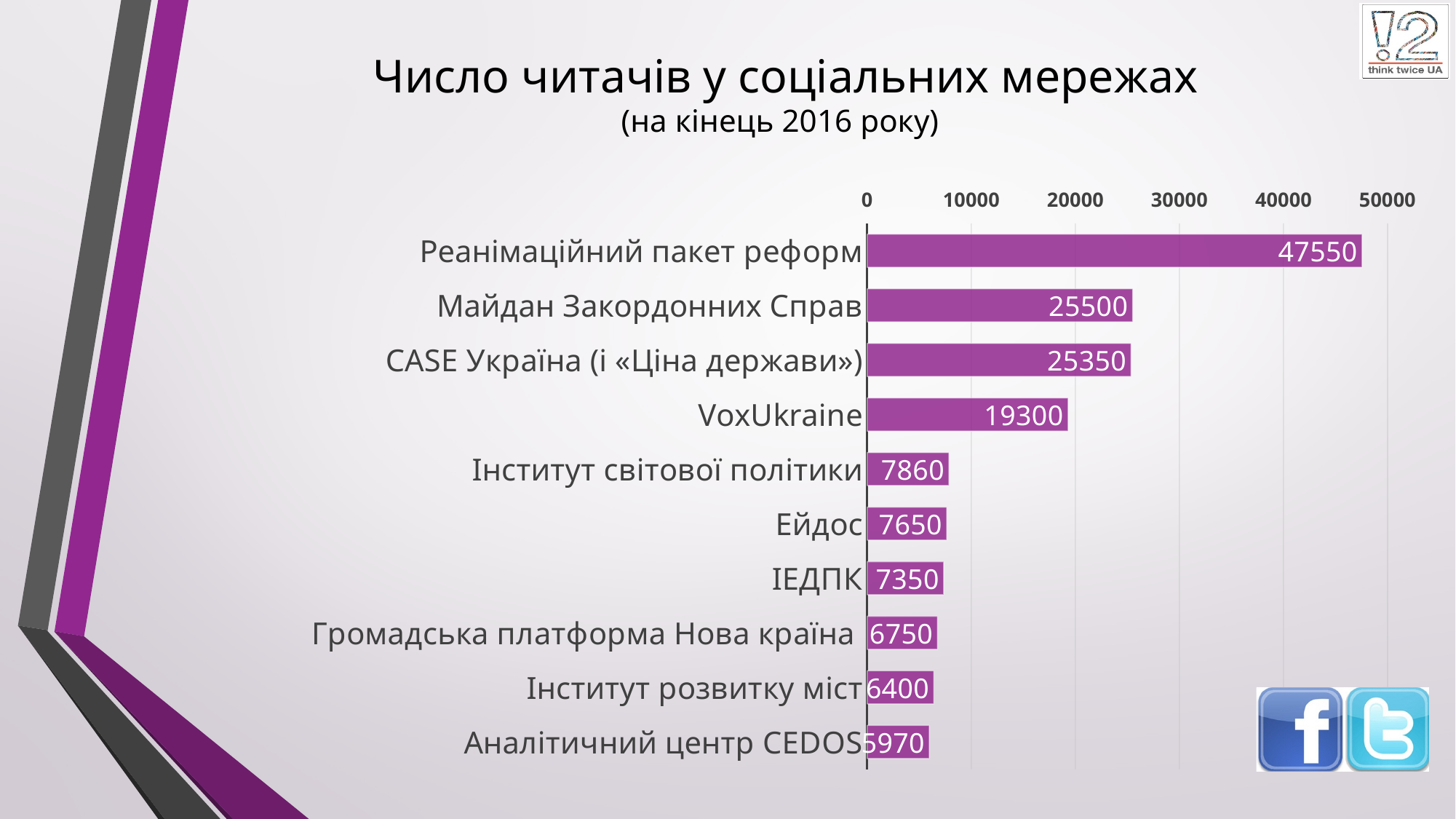
Which is larger, the value for ІЕДПК or the value for Громадська платформа Нова країна? ІЕДПК What is the value for VoxUkraine? 19300 Which category has the lowest value? Аналітичний центр CEDOS Is the value for CASE Україна (і «Ціна держави») greater or less than 20000? greater What is the value for Ейдос? 7650 How many categories are shown in the chart? 10 What is the value for Аналітичний центр CEDOS? 5970 What is the difference between the values for VoxUkraine and Інститут світової політики? 11440 What kind of chart is shown on the slide? bar chart Which category has the highest value? Реанімаційний пакет реформ What is the difference between the values for Реанімаційний пакет реформ and Майдан Закордонних Справ? 22050 What is the value for Реанімаційний пакет реформ? 47550